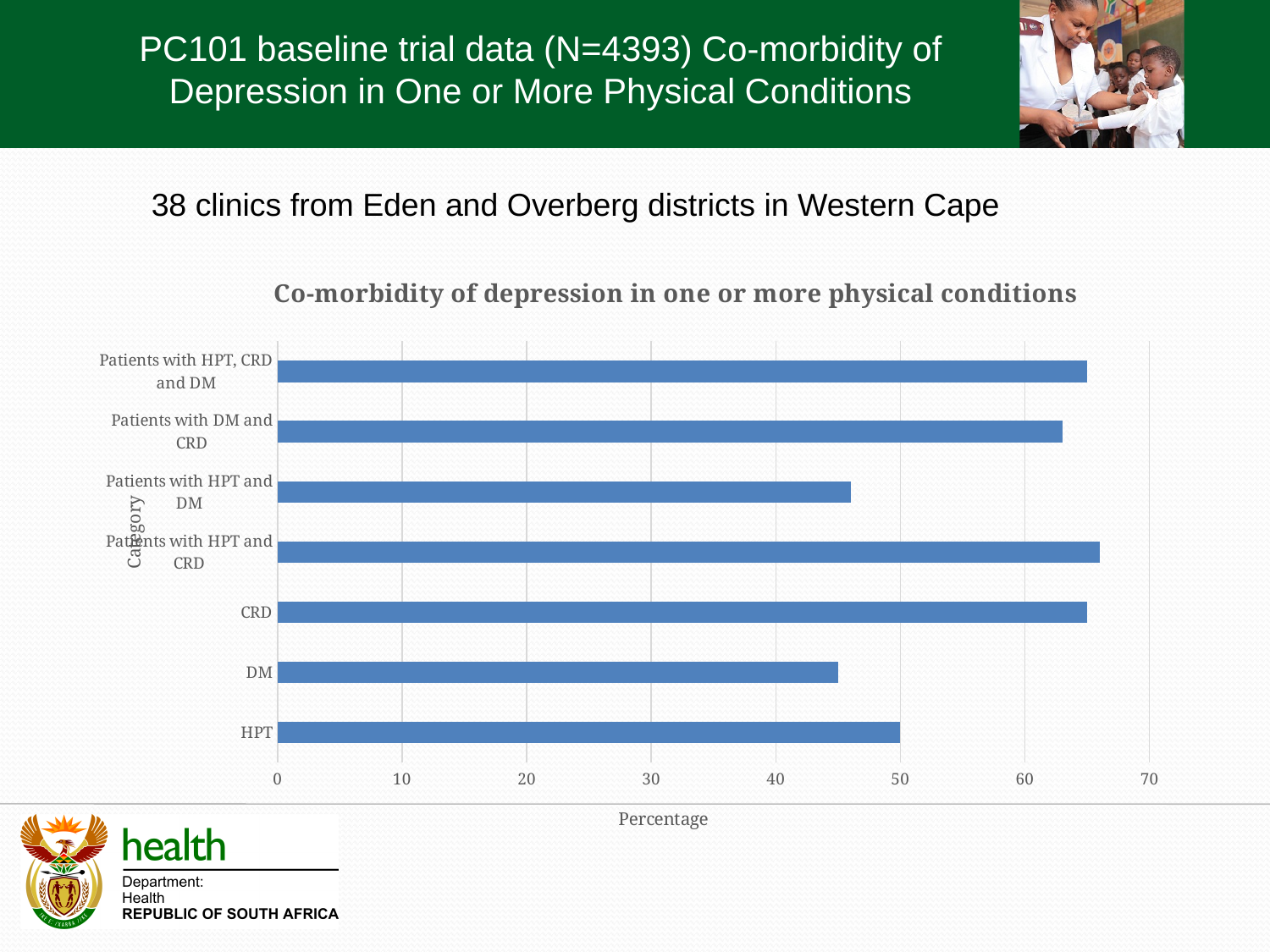
How many categories are plotted in the chart? 7 Which has the larger value, HPT or DM? HPT Is the value for Patients with DM and CRD greater or less than 60? greater What is the label on the horizontal axis of the chart? Percentage What kind of chart is shown on the slide? bar chart Is the value for CRD greater or less than 60? greater Which has the larger value, CRD or Patients with HPT and DM? CRD What is the title of the chart? Co-morbidity of depression in one or more physical conditions Is the value for Patients with HPT and DM greater or less than 50? less